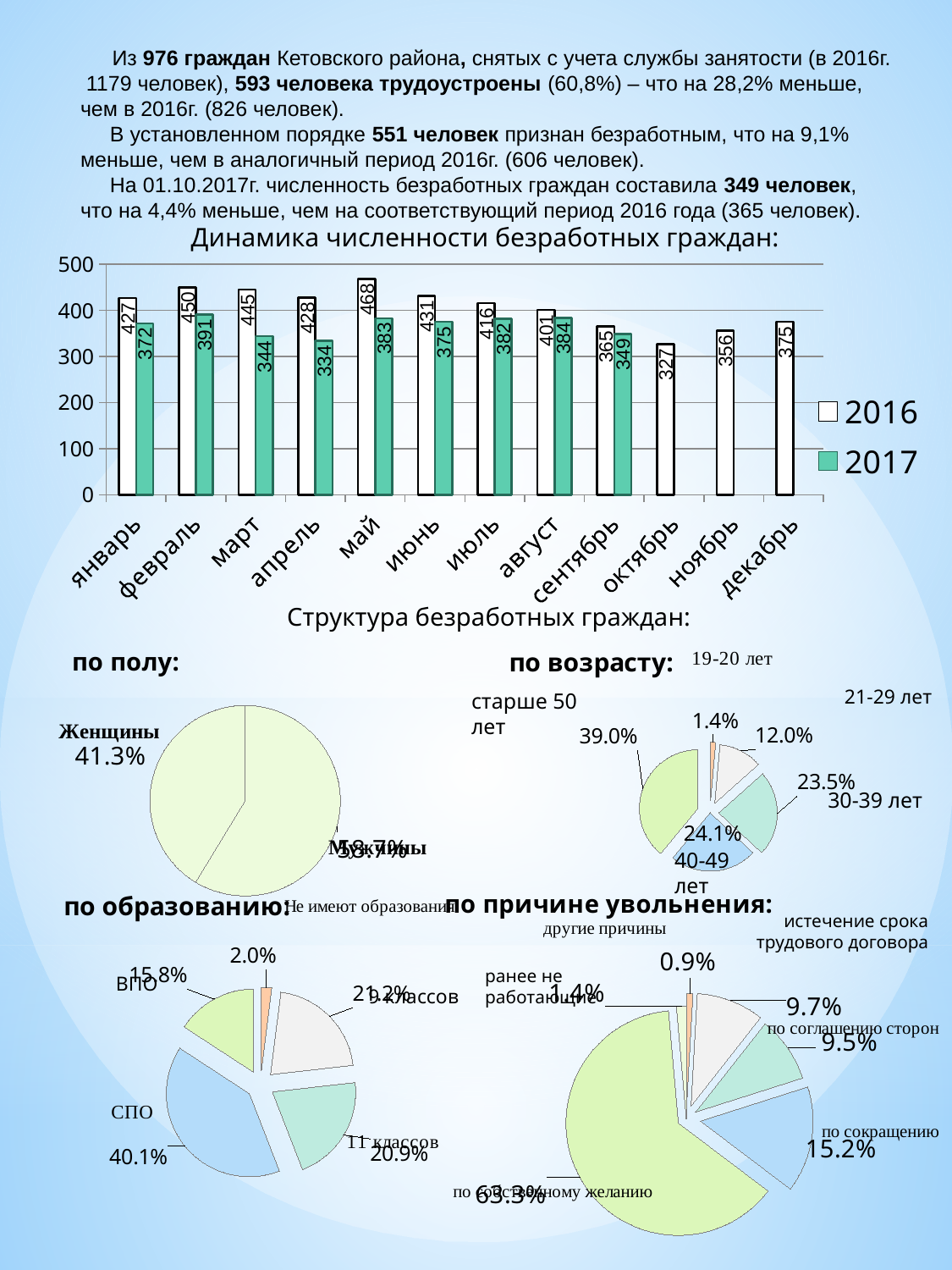
In the pie chart 'по возрасту', what share is shown for старше 50 лет? 39.0% In the pie chart 'по образованию', which category has the largest share? СПО In the chart 'Динамика численности безработных граждан', what is the difference between the 2016 and 2017 values for март? 101 In the chart 'Динамика численности безработных граждан', what is the value for май in the 2016 series? 468 In the pie chart 'по причине увольнения', what share is shown for по сокращению? 15.2% In the chart 'Динамика численности безработных граждан', how many series does the legend list? 2 What kind of chart is 'Динамика численности безработных граждан'? bar chart In the chart 'Динамика численности безработных граждан', what is the value for сентябрь in the 2017 series? 349 In the chart 'Динамика численности безработных граждан', how many months have a value plotted for the 2017 series? 9 In the chart 'Динамика численности безработных граждан', which month has the lowest value in the 2016 series? октябрь In the chart 'Динамика численности безработных граждан', which month has the highest value in the 2016 series? май In the pie chart 'по полу', which group has the larger share, Женщины or Мужчины? Мужчины